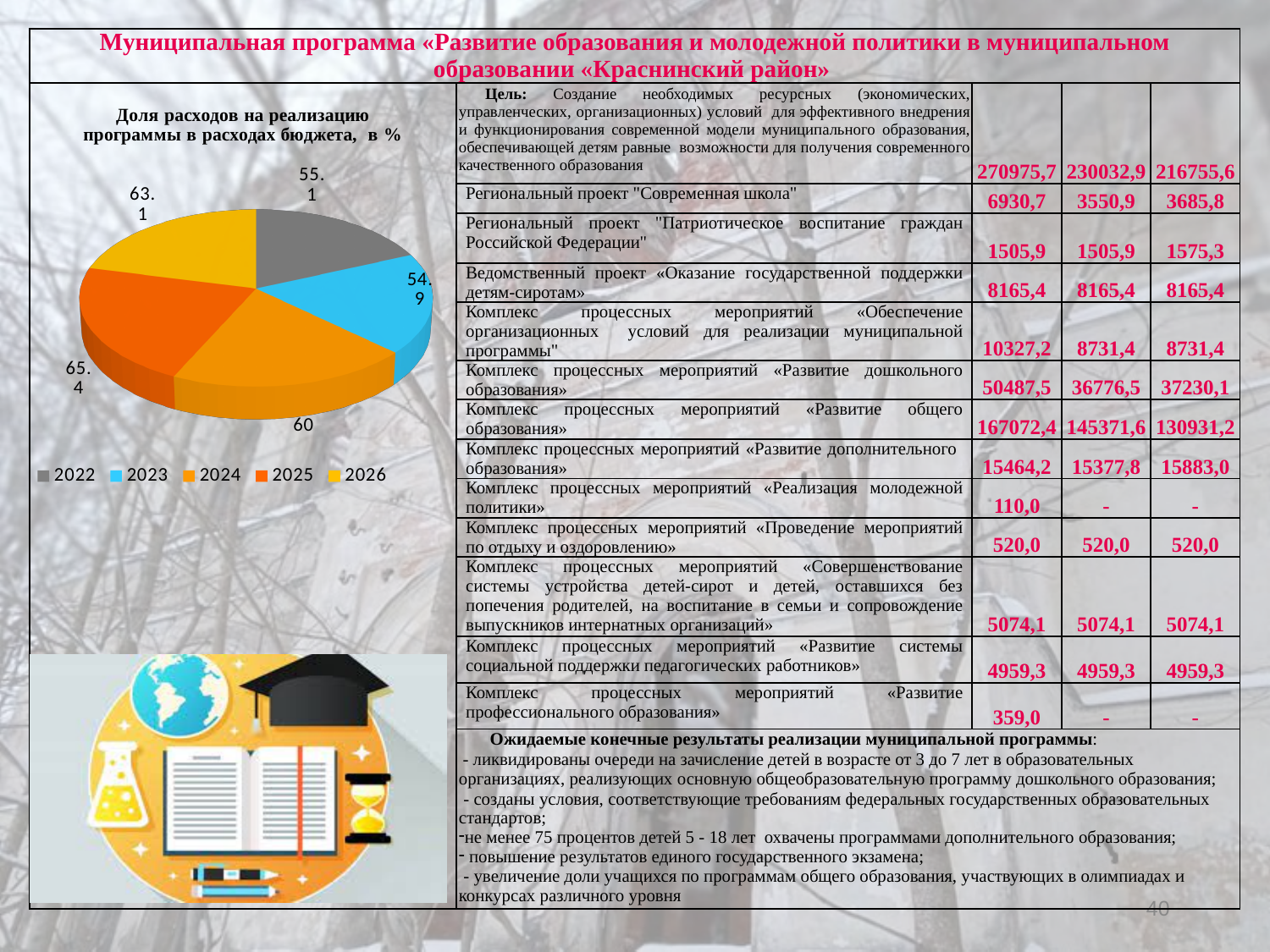
Which year has the highest value in the pie chart? 2025 Which year has the lowest value in the pie chart? 2023 What is the value for 2025 in the pie chart? 65.4 What is the title of the pie chart? Доля расходов на реализацию программы в расходах бюджета, в % What is the value for 2022 in the pie chart? 55.1 What type of chart is shown on the left of the slide? pie chart How many entries does the pie chart legend list? 5 What is the value for 2023 in the pie chart? 54.9 What is the value for 2024 in the pie chart? 60 What is the value for 2026 in the pie chart? 63.1 What is the difference between the values for 2025 and 2024 in the pie chart? 5.4 How many slices does the pie chart have? 5